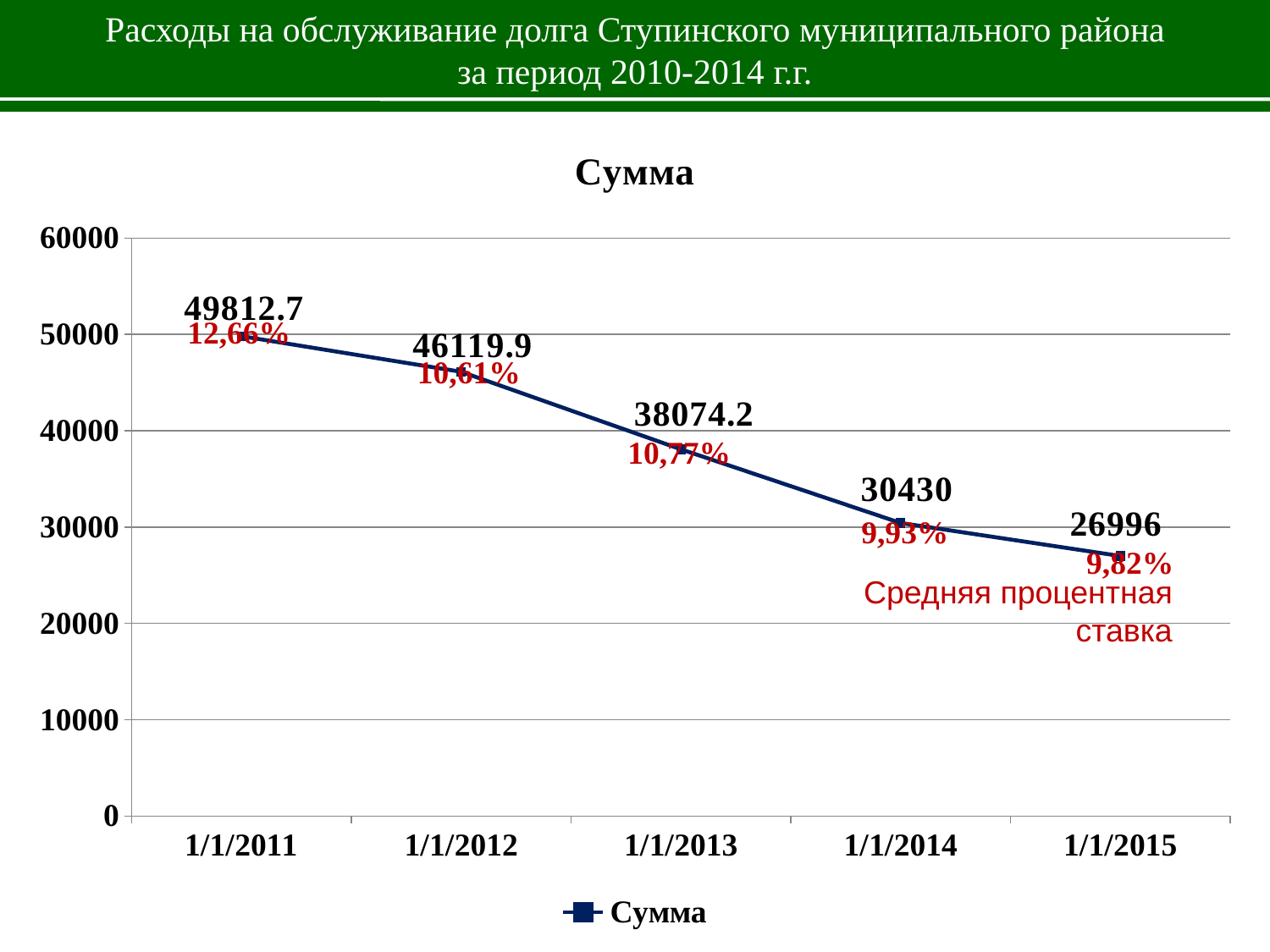
Which is larger, the value for 1/1/2012 or the value for 1/1/2013? 1/1/2012 Is the value for 1/1/2014 greater or less than 40000? less How many data points are plotted on the chart? 5 What is the difference between the values for 1/1/2014 and 1/1/2015? 3434 What is the value for 1/1/2013? 38074.2 Which date has the highest value? 1/1/2011 What is the value for 1/1/2015? 26996 How many series does the legend list? 1 Which date has the lowest value? 1/1/2015 What is the value for 1/1/2011? 49812.7 Do the values rise or fall from 1/1/2011 to 1/1/2015? fall What kind of chart is shown? line chart